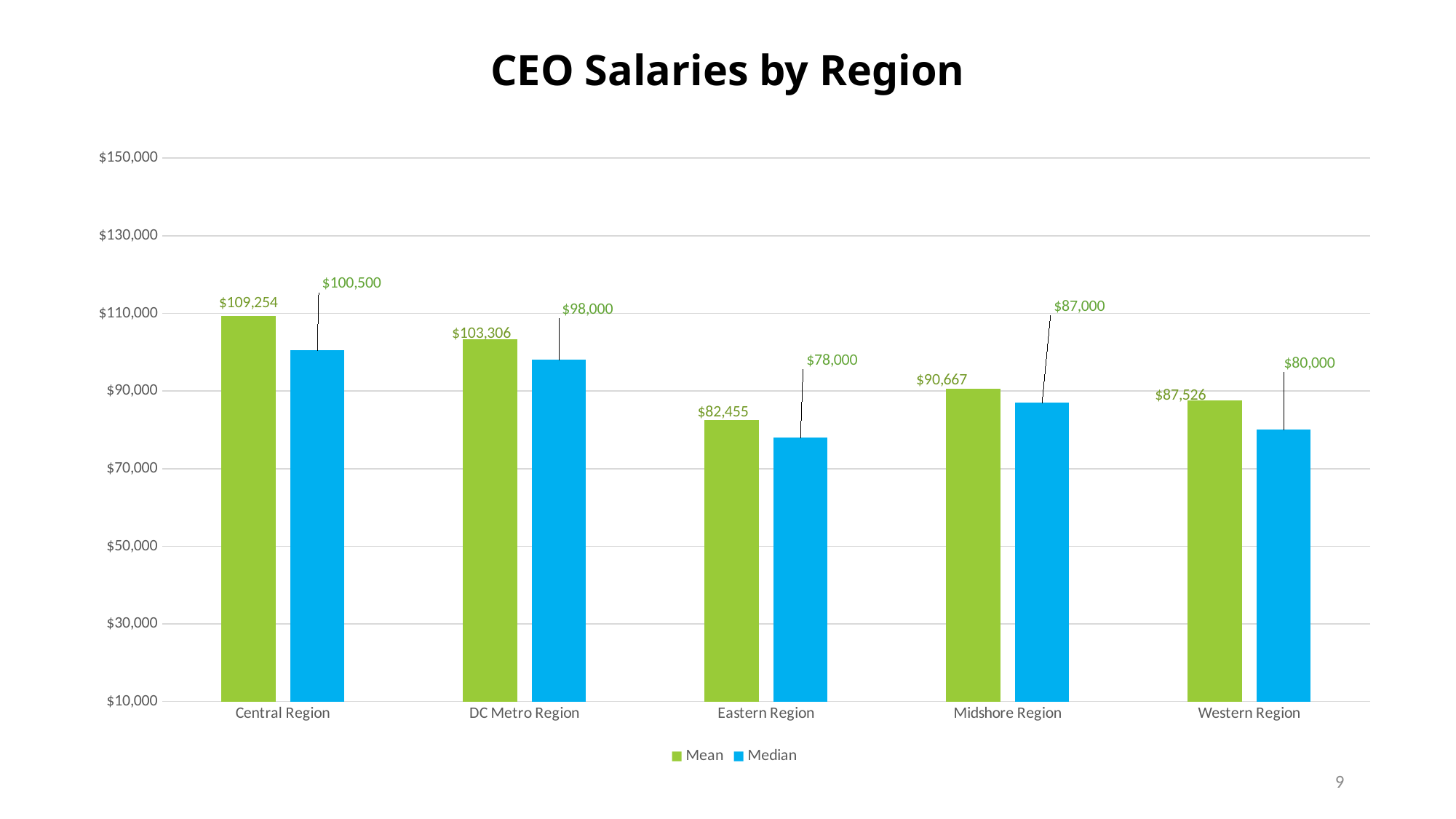
What is the mean CEO salary for the Western Region? $87,526 What is the median CEO salary for the Eastern Region? $78,000 Which is larger, the mean CEO salary in the Midshore Region or in the Western Region? Midshore Region Is the median CEO salary for the Midshore Region greater or less than $90,000? less Which region has the highest mean CEO salary? Central Region What type of chart is shown on the slide? Bar chart What is the difference between the median CEO salaries of the DC Metro Region and the Western Region? $18,000 What is the difference between the mean and median CEO salary in the Central Region? $8,754 How many regions are shown on the chart? 5 Which region has the lowest median CEO salary? Eastern Region What is the mean CEO salary for the Central Region? $109,254 How many series does the legend list? 2